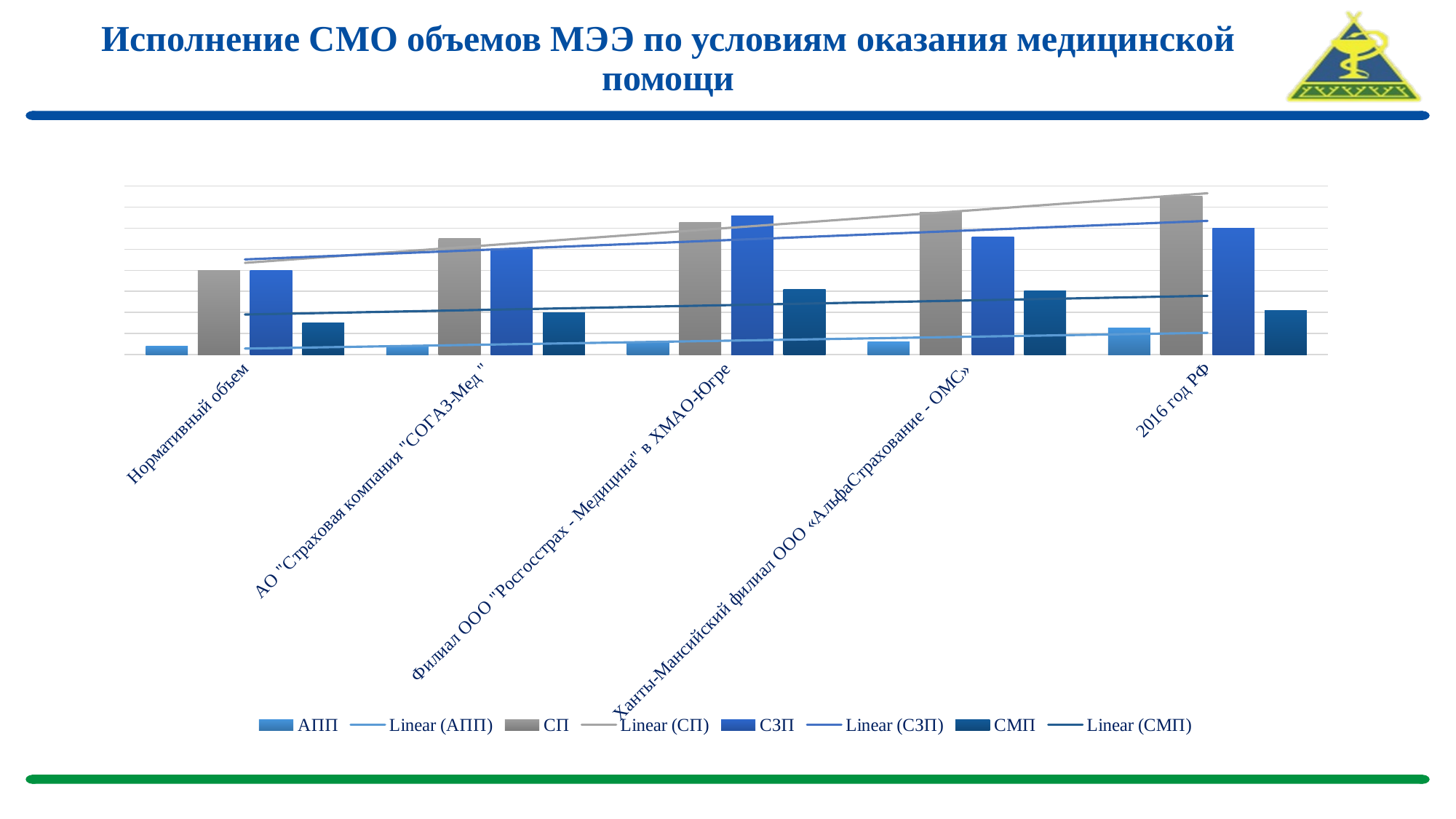
What is the title of the slide containing the chart? Исполнение СМО объемов МЭЭ по условиям оказания медицинской помощи Which category has the lowest value for the СП series? Нормативный объем How many categories are shown along the x axis of the chart? 5 Which category has the lowest value for the СЗП series? Нормативный объем In the category 2016 год РФ, which is larger: the СП value or the СЗП value? СП What kind of chart is shown on the slide? Bar chart with linear trend lines How many bar series (excluding trend lines) are plotted in the chart? 4 How many entries does the chart legend list? 8 Which category has the highest value for the АПП series? 2016 год РФ Do the СП values rise or fall moving from Нормативный объем to 2016 год РФ along the x axis? Rise Which category has the highest value for the СП series? 2016 год РФ In the category Нормативный объем, which is larger: the СП value or the СМП value? СП